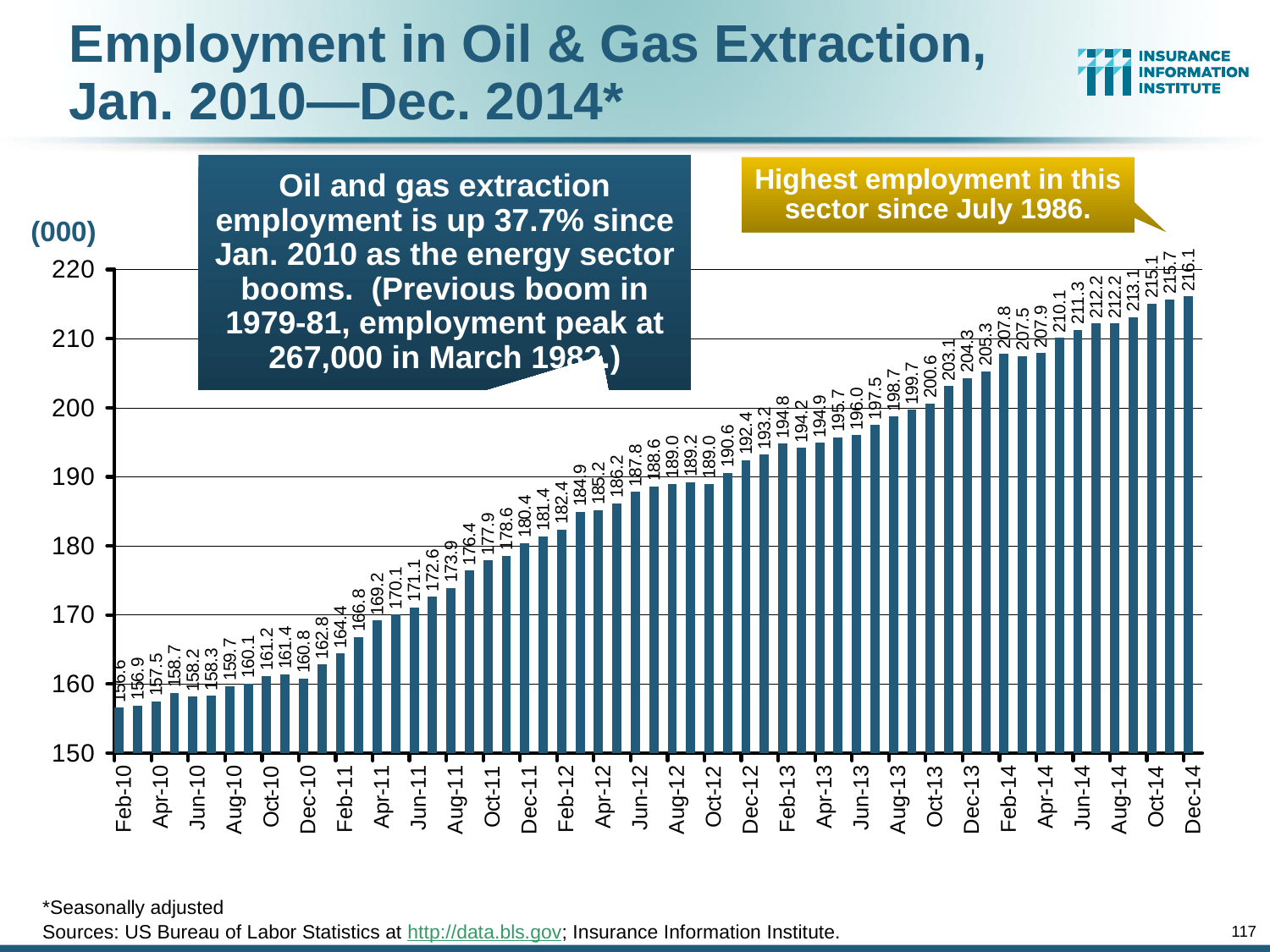
Do the employment values generally rise or fall from left to right across the chart? Rise What is the employment value (in thousands) for Nov-14? 215.7 Which month has the highest employment value on the chart? Dec-14 What is the employment value (in thousands) for Dec-14? 216.1 Is the value for Feb-10 greater or less than 160? less What is the difference between the Dec-14 value and the Nov-14 value? 0.4 According to the callout, by what percentage is oil and gas extraction employment up since Jan. 2010? 37.7% Is the value for Dec-14 greater or less than 210? greater What kind of chart is used to show employment in oil & gas extraction? Bar chart Which is larger, the employment value for Dec-14 or for Dec-10? Dec-14 What is the lowest value shown on the vertical axis? 150